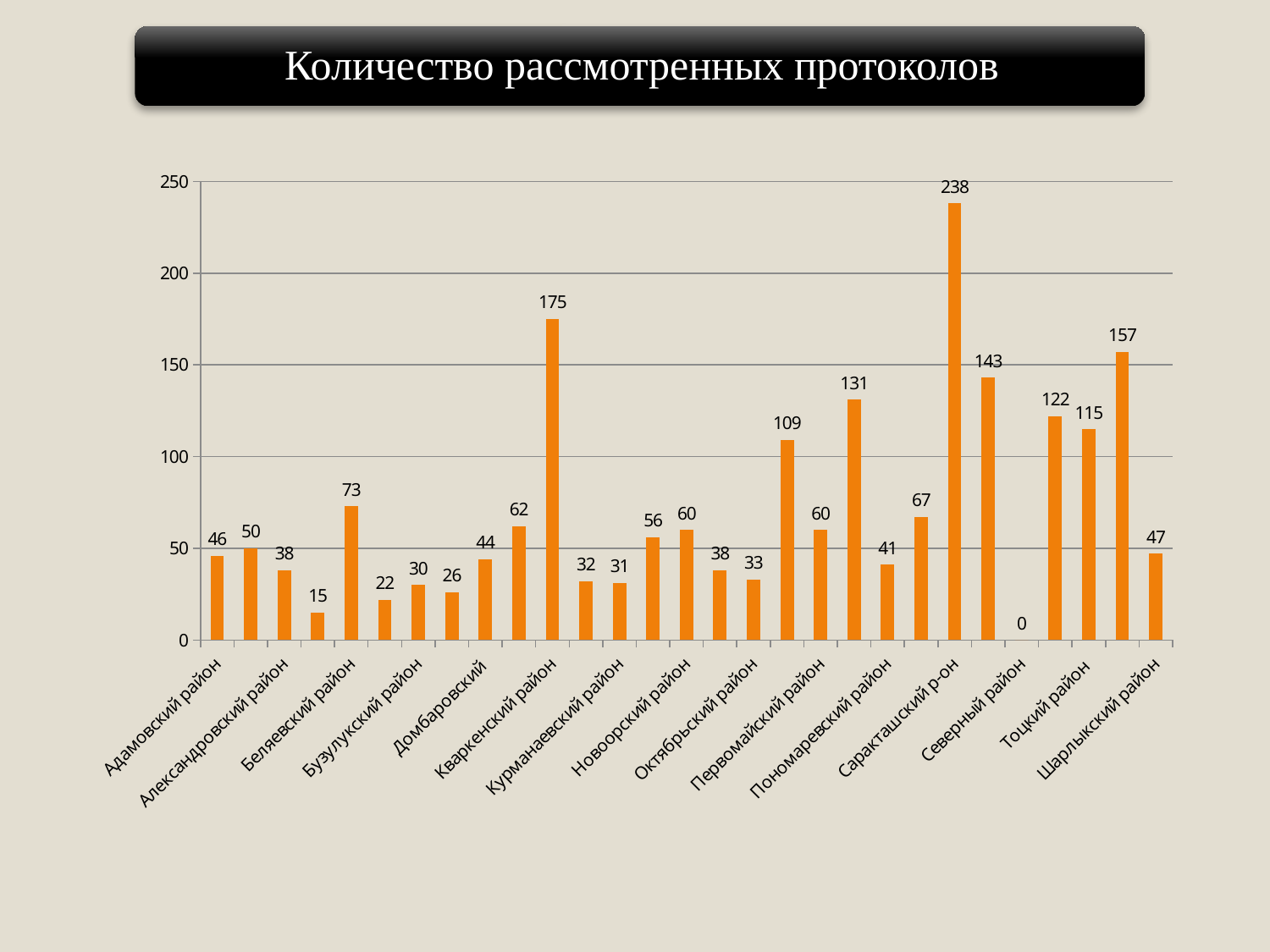
Is the value for Кваркенский район greater or less than 150? greater What kind of chart is shown on the slide? bar chart Which category has the lowest value? Северный район What is the value for Адамовский район? 46 Which is larger, the value for Кваркенский район or the value for Тоцкий район? Кваркенский район Which category has the highest value? Саракташский р-он What is the value for Саракташский р-он? 238 How many bars are plotted in the chart? 29 What is the value for Северный район? 0 What is the title of the chart? Количество рассмотренных протоколов What is the difference between the values for Саракташский р-он and Кваркенский район? 63 What is the value for Кваркенский район? 175